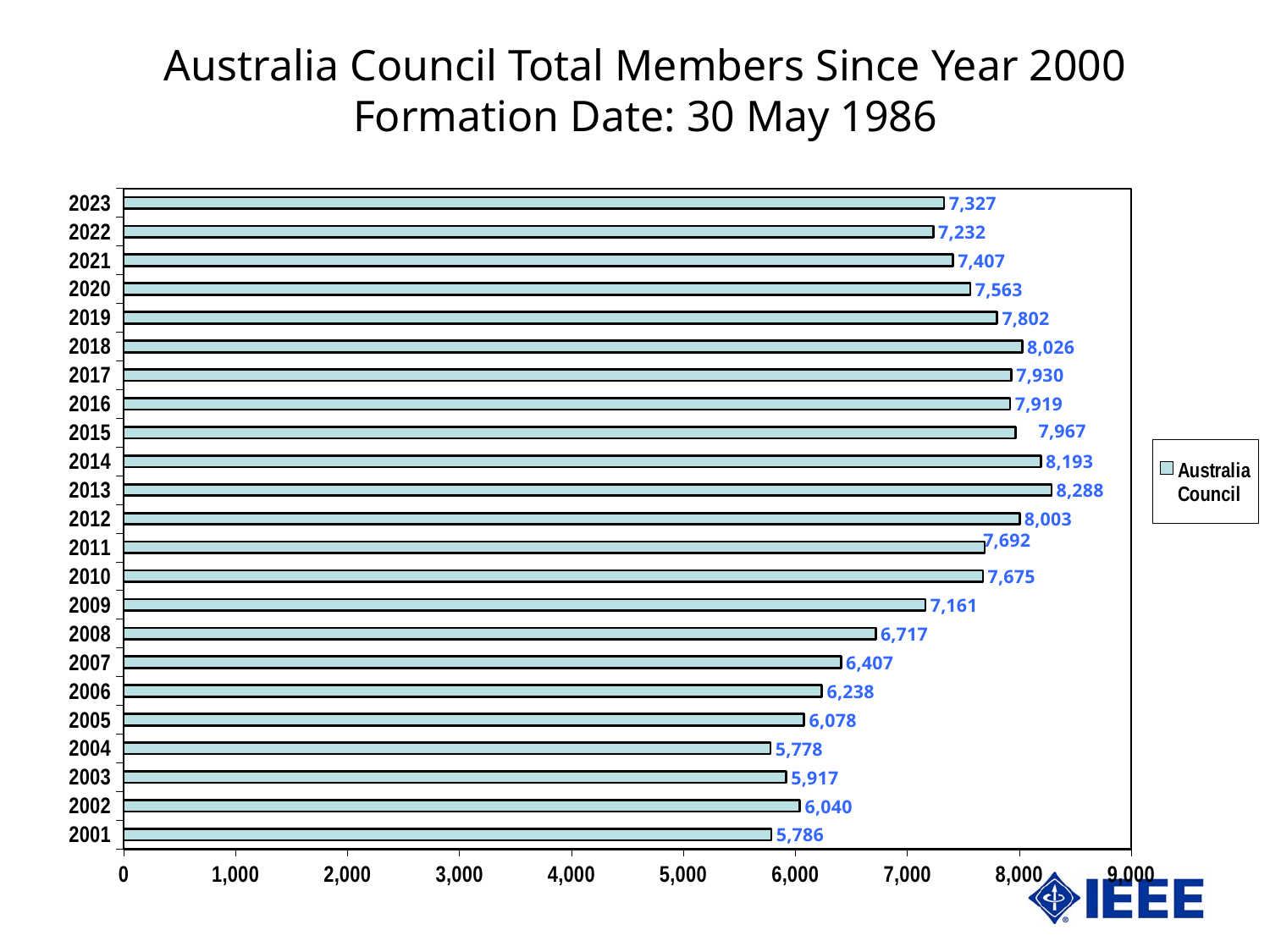
What was the Australia Council total membership in 2023? 7,327 How many years are shown on the chart? 23 How many series does the legend list? 1 Which year had more members, 2009 or 2010? 2010 What is the difference in membership between 2018 and 2017? 96 What is the difference in membership between 2013 and 2001? 2,502 What kind of chart is shown on the slide? Bar chart What was the Australia Council total membership in 2013? 8,288 Is the membership value for 2008 greater or less than 7,000? less Which year had the highest total membership? 2013 Which year had the lowest total membership? 2004 What was the Australia Council total membership in 2001? 5,786